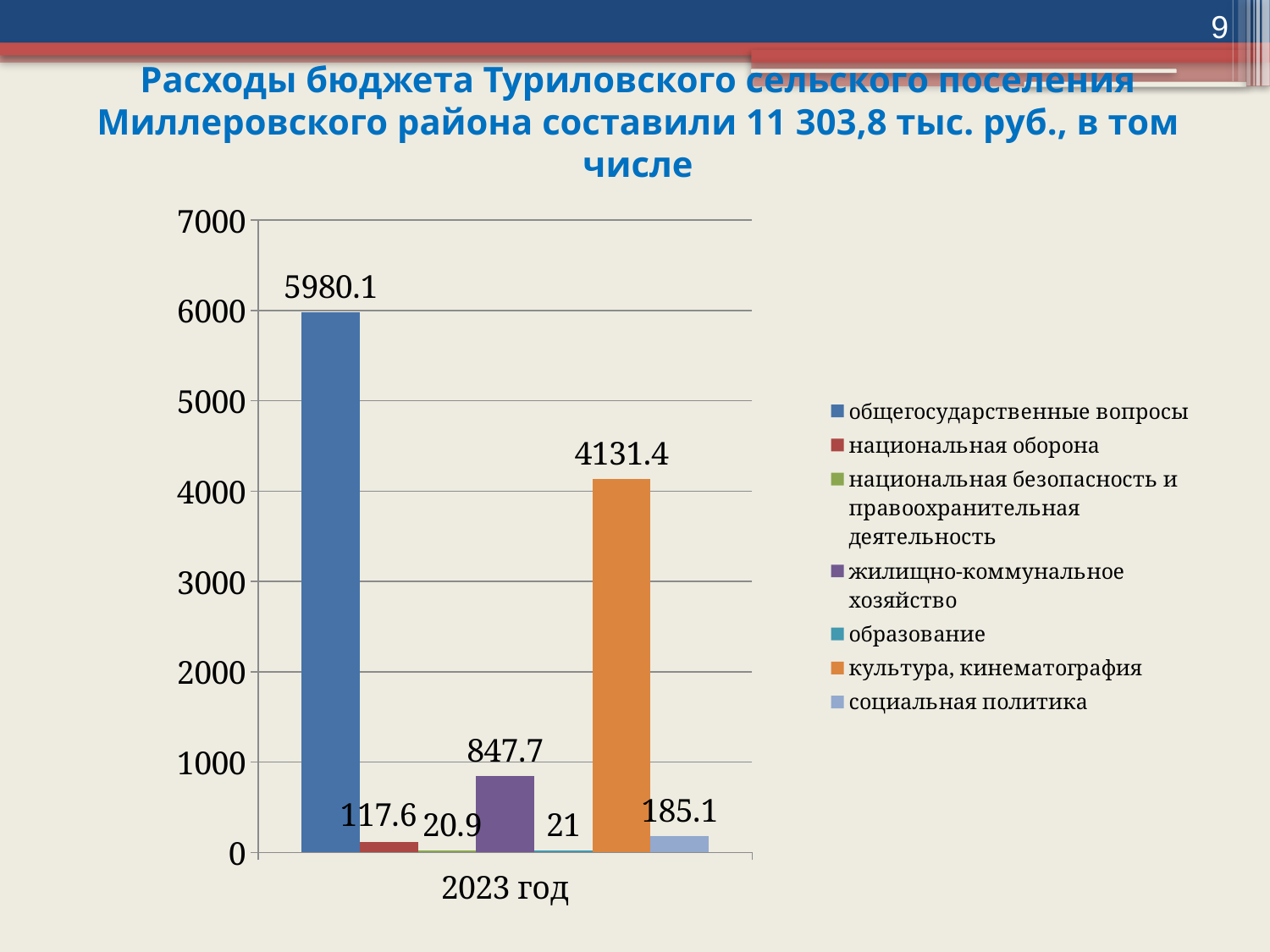
Is the value for жилищно-коммунальное хозяйство greater or less than 1000? less What is the value for жилищно-коммунальное хозяйство? 847.7 What is the difference between общегосударственные вопросы and культура, кинематография? 1848.7 What kind of chart is shown on the slide? bar chart What colour is the bar for культура, кинематография? orange Which is larger, национальная оборона or социальная политика? социальная политика What is the value for общегосударственные вопросы in 2023 год? 5980.1 Which series has the highest value in 2023 год? общегосударственные вопросы What is the value for культура, кинематография in 2023 год? 4131.4 How many series does the legend list? 7 What is the value for социальная политика? 185.1 What is the category label on the x axis? 2023 год